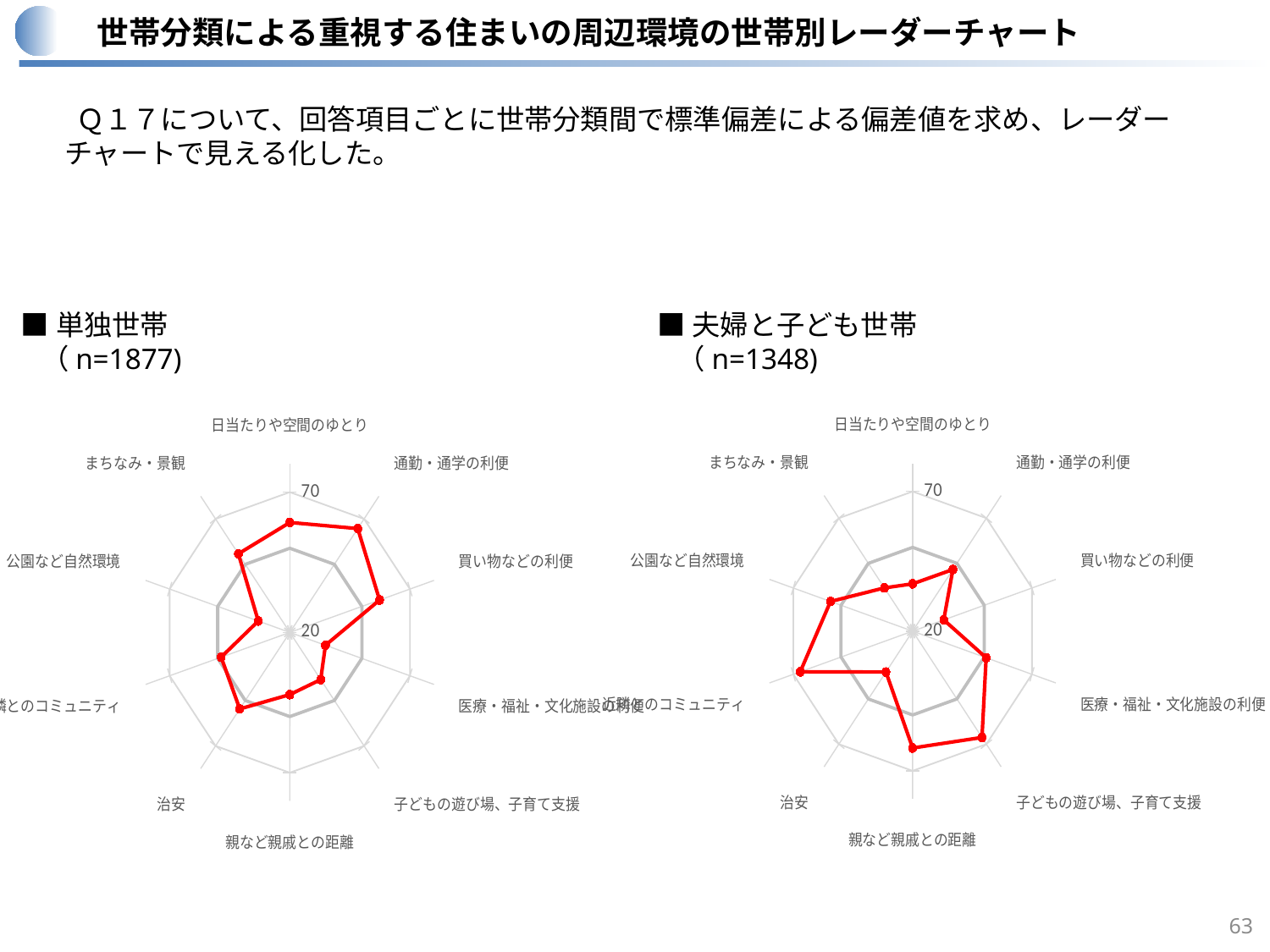
How many categories (axes) does the 単独世帯 radar chart have? 10 What is the sample size (n) shown for the 夫婦と子ども世帯 chart? n=1348 How many categories (axes) does the 夫婦と子ども世帯 radar chart have? 10 In the 単独世帯 chart, which is larger: 通勤・通学の利便 or 子どもの遊び場、子育て支援? 通勤・通学の利便 What is the sample size (n) shown for the 単独世帯 chart? n=1877 In the 単独世帯 chart, is the value for 親など親戚との距離 greater or less than 70? less In the 夫婦と子ども世帯 chart, which is larger: 子どもの遊び場、子育て支援 or 通勤・通学の利便? 子どもの遊び場、子育て支援 In the 夫婦と子ども世帯 chart, which is larger: 近隣とのコミュニティ or 日当たりや空間のゆとり? 近隣とのコミュニティ In the 夫婦と子ども世帯 chart, is the value for 通勤・通学の利便 greater or less than 70? less How many data series are plotted in each radar chart? 2 What kind of chart is used on this slide? Radar chart